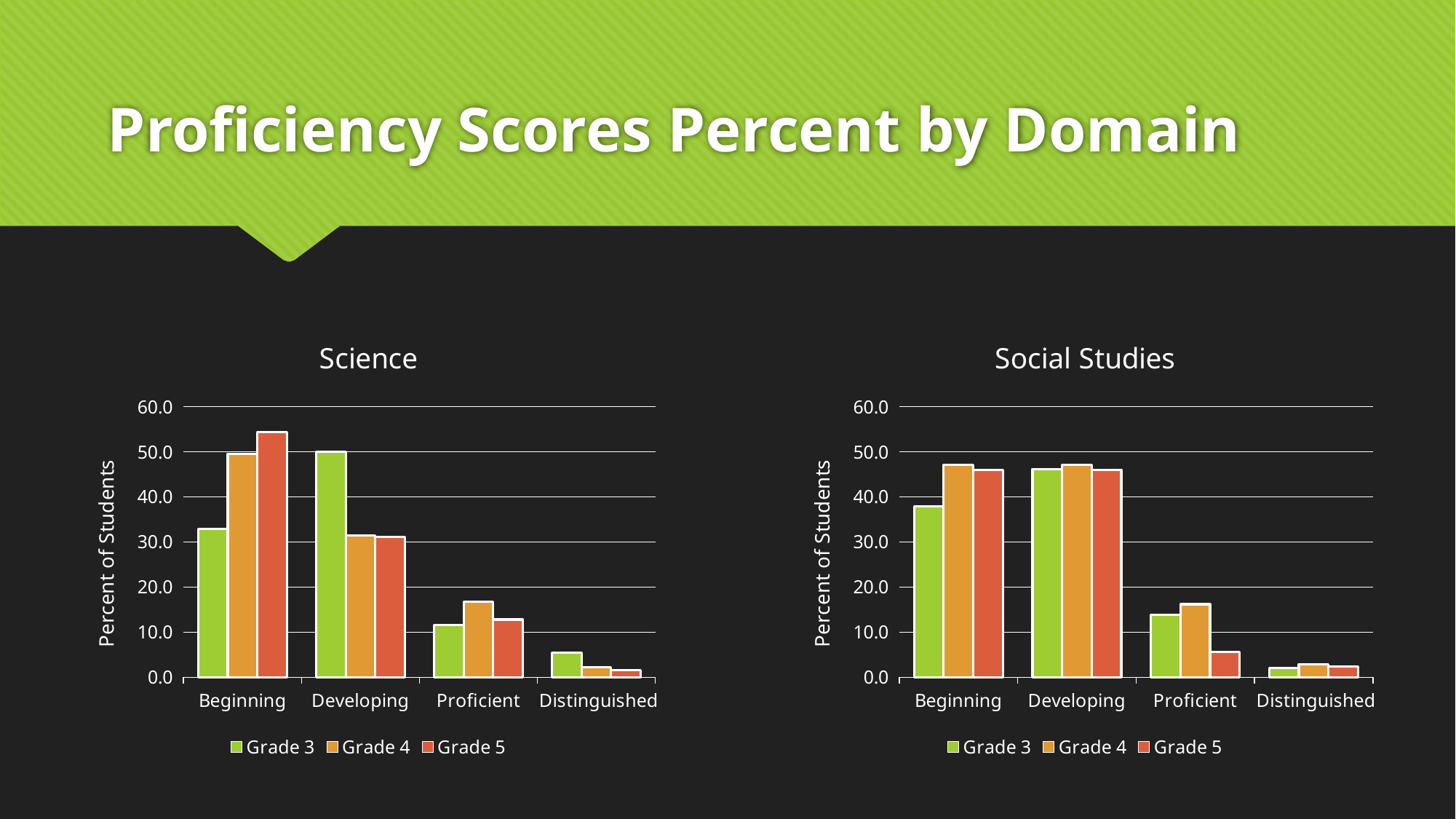
In the Social Studies chart, which is larger at Proficient: Grade 3 or Grade 5? Grade 3 In the Science chart, is the value for Grade 3 at Developing greater or less than 40.0? greater In the Science chart, which is larger at Beginning: Grade 3 or Grade 5? Grade 5 In the Social Studies chart, which grade has the lowest value at Beginning? Grade 3 How many series does the legend of the Social Studies chart list? 3 How many proficiency categories are shown on the x axis of the Science chart? 4 In the Science chart, which grade has the highest value at Beginning? Grade 5 In the Social Studies chart, is the value for Grade 5 at Proficient greater or less than 10.0? less In the Social Studies chart, is the value for Grade 3 at Beginning greater or less than 40.0? less What kind of chart is the Science chart? bar chart In the Science chart, which grade has the highest value at Developing? Grade 3